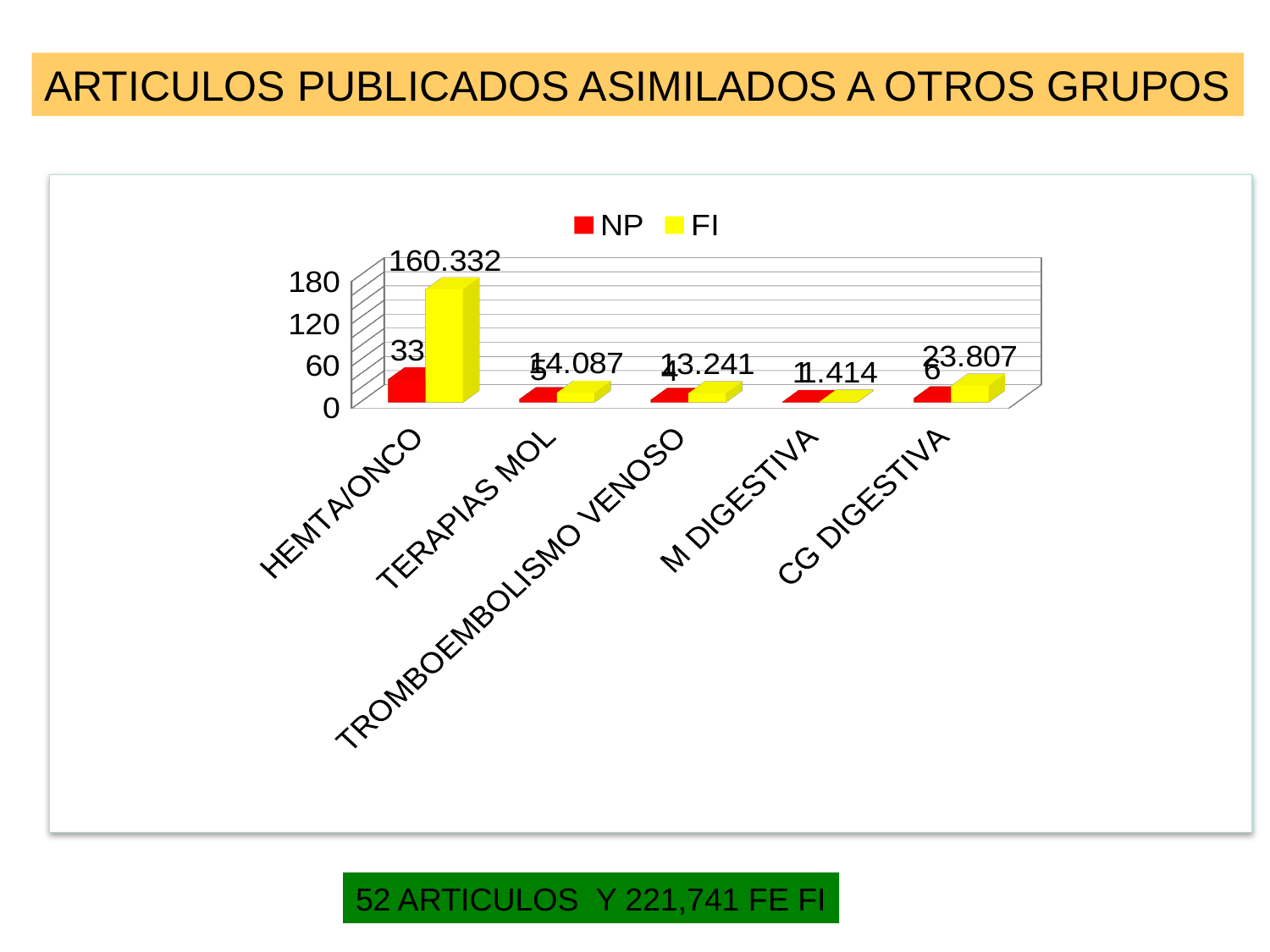
What is the NP value for CG DIGESTIVA? 6 What is the FI value for CG DIGESTIVA? 23.807 How many series does the legend list? 2 What kind of chart is shown on the slide? bar chart Which series is shown in yellow in the legend? FI Which category has the lowest FI value? M DIGESTIVA How many categories are shown on the x axis? 5 What is the FI value for HEMTA/ONCO? 160.332 Which category has the highest FI value? HEMTA/ONCO Is the FI value for HEMTA/ONCO greater or less than 120? greater What is the NP value for HEMTA/ONCO? 33 What is the FI value for TERAPIAS MOL? 14.087